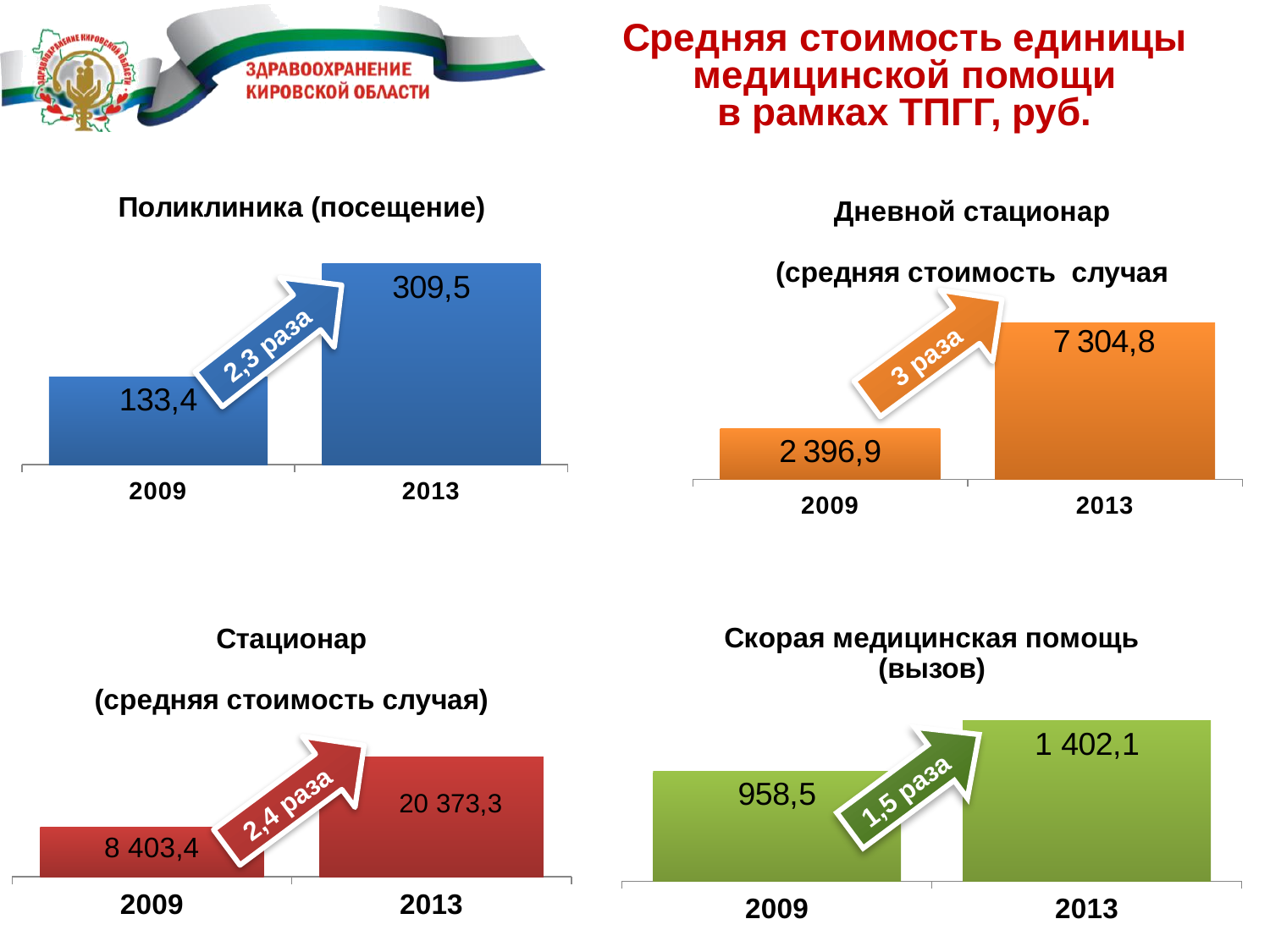
How many categories are shown on the x axis of the 'Стационар' chart? 2 In the 'Стационар' chart, what is the difference between the 2013 and 2009 values? 11 969,9 In the 'Поликлиника (посещение)' chart, which year has the higher value? 2013 In the 'Стационар' chart, what is the value for 2013? 20 373,3 In the 'Скорая медицинская помощь (вызов)' chart, what is the value for 2009? 958,5 In the 'Скорая медицинская помощь (вызов)' chart, what is the difference between the 2013 and 2009 values? 443,6 What type of chart is the 'Скорая медицинская помощь (вызов)' chart? Bar chart In the 'Поликлиника (посещение)' chart, what is the value for 2013? 309,5 In the 'Поликлиника (посещение)' chart, what is the value for 2009? 133,4 In the 'Дневной стационар' chart, what is the value for 2009? 2 396,9 In the 'Дневной стационар' chart, which year has the lowest value? 2009 In the 'Дневной стационар' chart, what is the value for 2013? 7 304,8